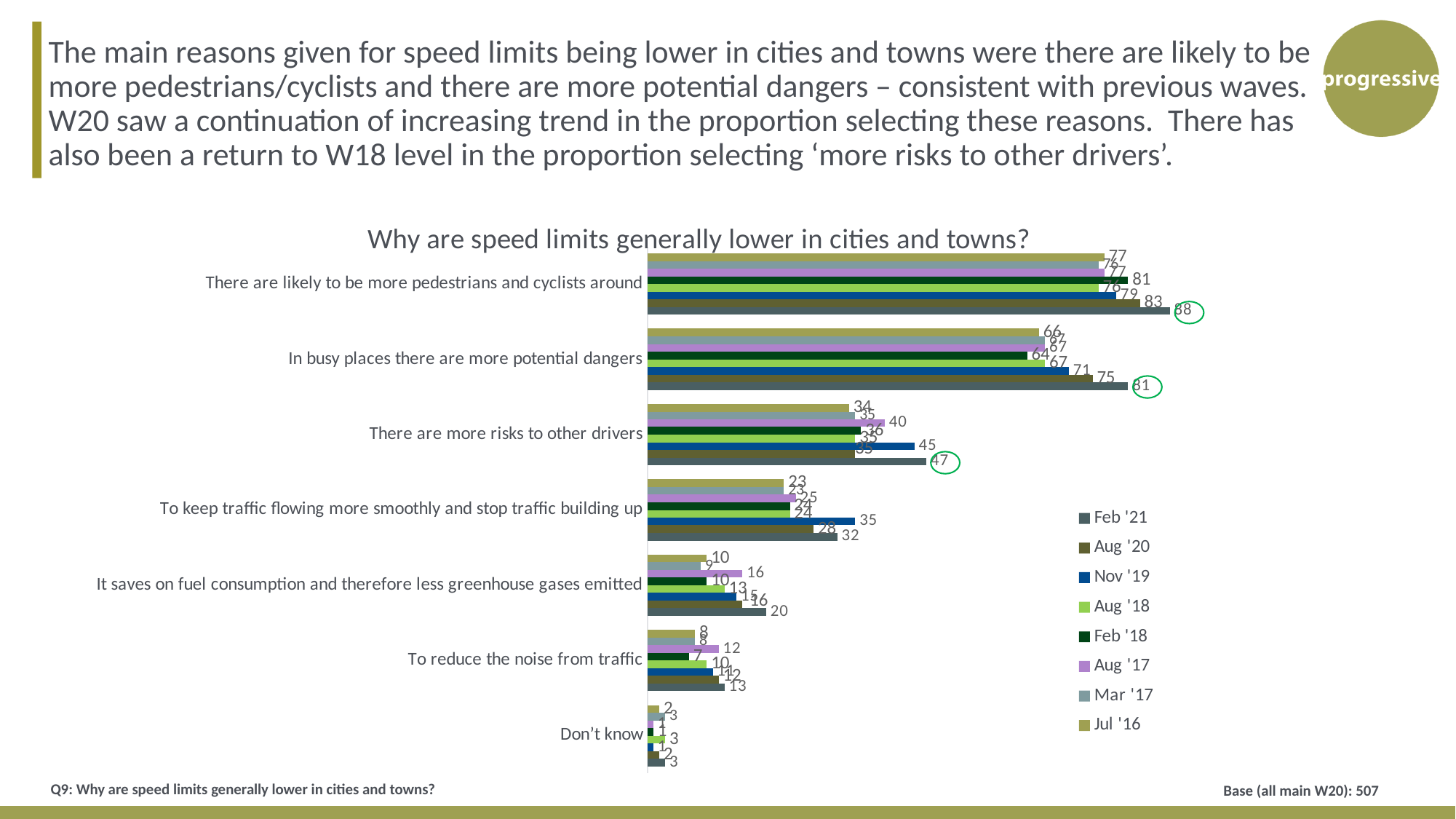
Which category has the highest Feb '21 value? There are likely to be more pedestrians and cyclists around What is the Nov '19 value for 'There are more risks to other drivers'? 45 Which category has the lowest Feb '21 value? Don't know What kind of chart is shown on the slide? Bar chart What is the Aug '17 value for 'There are more risks to other drivers'? 40 For 'To keep traffic flowing more smoothly and stop traffic building up', which is larger: the Nov '19 value or the Feb '21 value? Nov '19 What is the difference between the Feb '21 and Aug '20 values for 'There are likely to be more pedestrians and cyclists around'? 5 What is the Feb '21 value for 'There are likely to be more pedestrians and cyclists around'? 88 How many reason categories are plotted on the chart? 7 How many series does the legend list? 8 What is the Feb '21 value for 'In busy places there are more potential dangers'? 81 What is the Feb '21 value for 'It saves on fuel consumption and therefore less greenhouse gases emitted'? 20